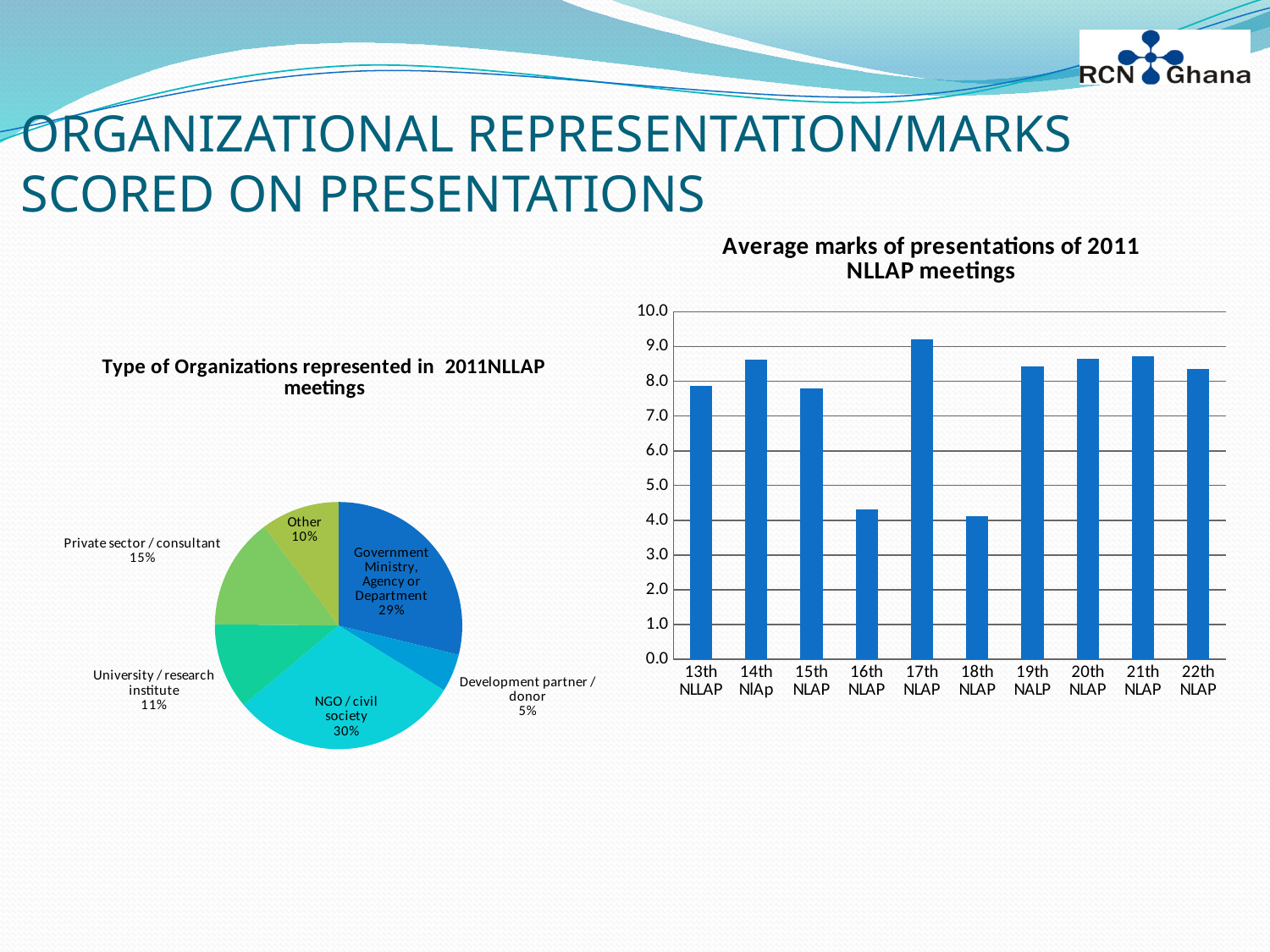
In the pie chart 'Type of Organizations represented in 2011NLLAP meetings', which is larger: Government Ministry, Agency or Department or Other? Government Ministry, Agency or Department What kind of chart is 'Average marks of presentations of 2011 NLLAP meetings'? Bar chart In the bar chart 'Average marks of presentations of 2011 NLLAP meetings', how many meetings are shown on the x axis? 10 In the bar chart 'Average marks of presentations of 2011 NLLAP meetings', is the value for 14th NlAp greater or less than 8.0? greater In the bar chart 'Average marks of presentations of 2011 NLLAP meetings', is the value for 16th NLAP greater or less than 5.0? less In the pie chart 'Type of Organizations represented in 2011NLLAP meetings', how many slices are there? 6 In the pie chart 'Type of Organizations represented in 2011NLLAP meetings', which type of organization has the smallest share? Development partner / donor In the pie chart 'Type of Organizations represented in 2011NLLAP meetings', what is the difference in percentage points between Private sector / consultant and University / research institute? 4 percentage points In the bar chart 'Average marks of presentations of 2011 NLLAP meetings', which meeting has the highest average mark? 17th NLAP In the pie chart 'Type of Organizations represented in 2011NLLAP meetings', what share is Development partner / donor? 5% In the pie chart 'Type of Organizations represented in 2011NLLAP meetings', what share is NGO / civil society? 30% In the pie chart 'Type of Organizations represented in 2011NLLAP meetings', which type of organization has the largest share? NGO / civil society